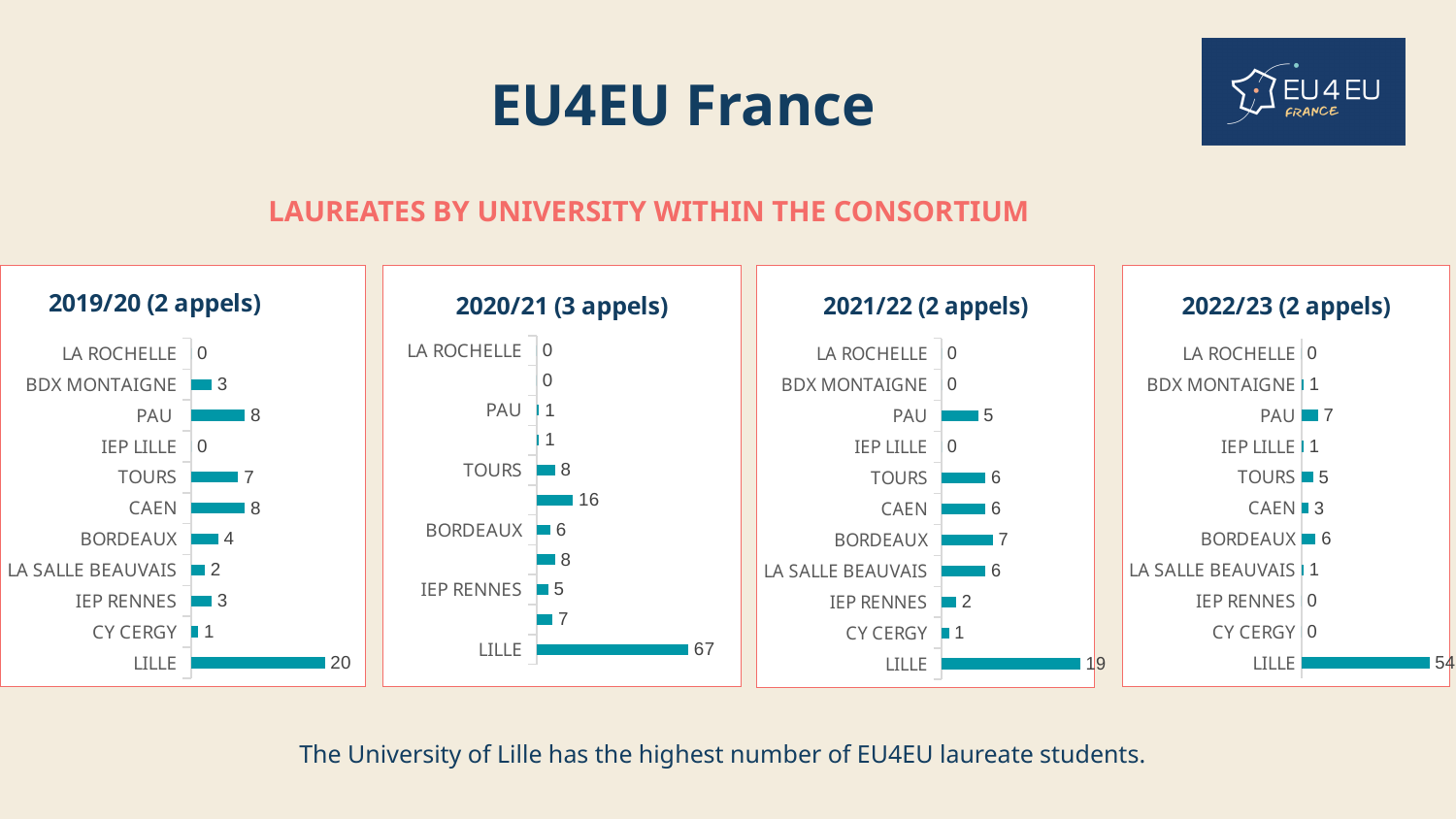
In the 2019/20 (2 appels) chart, what is the value for LILLE? 20 How many charts are shown on the slide? 4 In the 2022/23 (2 appels) chart, what is the difference between PAU and TOURS? 2 In the 2021/22 (2 appels) chart, what is the difference between LILLE and BORDEAUX? 12 In the 2020/21 (3 appels) chart, what is the value for LILLE? 67 In the 2019/20 (2 appels) chart, what is the value for PAU? 8 In the 2019/20 (2 appels) chart, which is larger, TOURS or BORDEAUX? TOURS In the 2021/22 (2 appels) chart, what is the value for BORDEAUX? 7 In the 2022/23 (2 appels) chart, which university has the highest value? LILLE In the 2022/23 (2 appels) chart, what is the value for LILLE? 54 What type of chart is used for the 2021/22 (2 appels) data? Bar chart How many universities are listed in the 2019/20 (2 appels) chart? 11